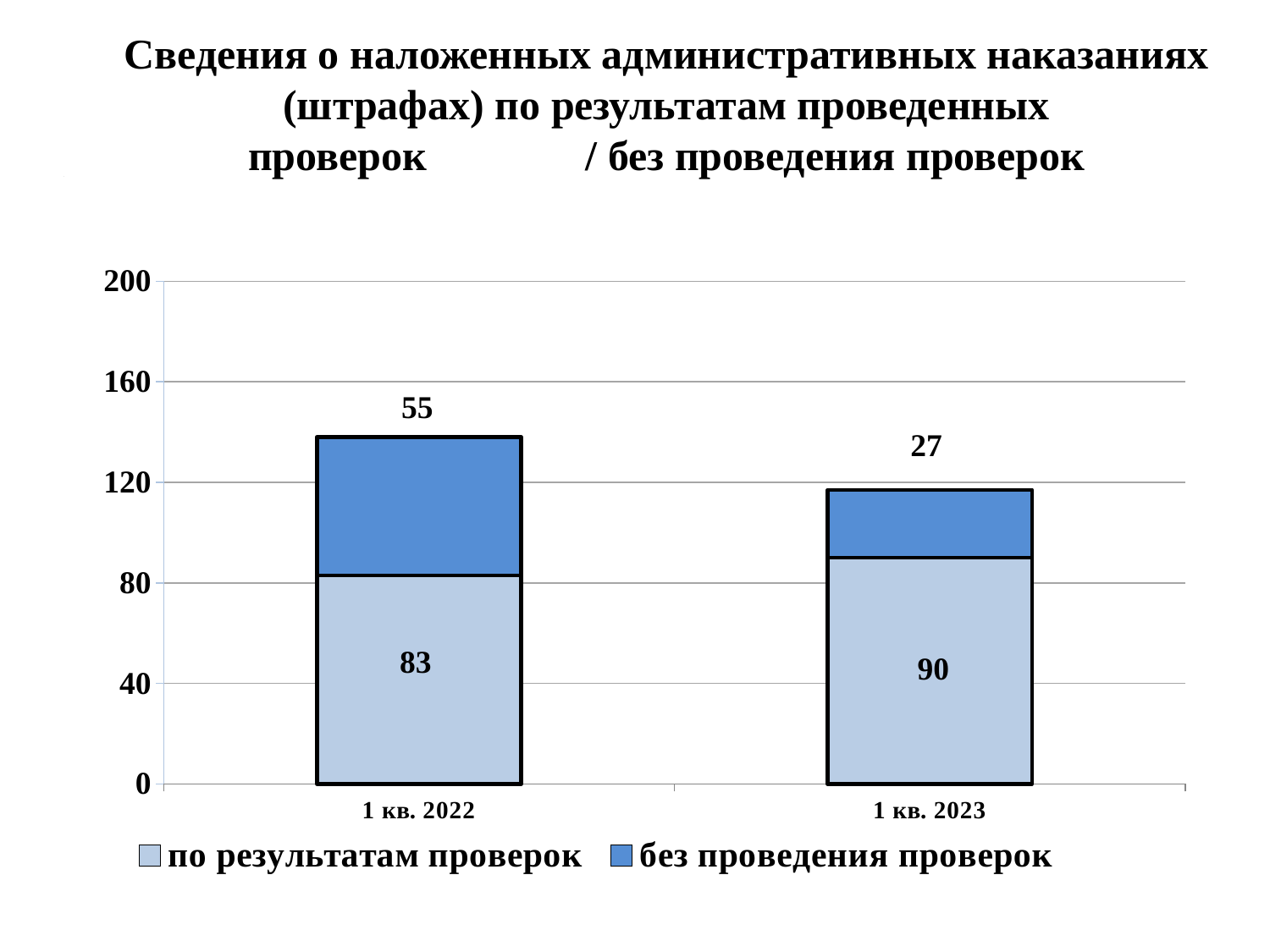
Which period has the larger value for "по результатам проверок", 1 кв. 2022 or 1 кв. 2023? 1 кв. 2023 What is the value for "без проведения проверок" in 1 кв. 2022? 55 What is the value for "по результатам проверок" in 1 кв. 2022? 83 How many series does the legend list? 2 What kind of chart is shown on the slide? Stacked bar chart What is the value for "без проведения проверок" in 1 кв. 2023? 27 What is the total of the stacked bar for 1 кв. 2022? 138 What is the value for "по результатам проверок" in 1 кв. 2023? 90 Which period has the higher total stacked bar? 1 кв. 2022 How many categories are shown on the x axis? 2 What is the difference between the "без проведения проверок" values for 1 кв. 2022 and 1 кв. 2023? 28 What is the total of the stacked bar for 1 кв. 2023? 117